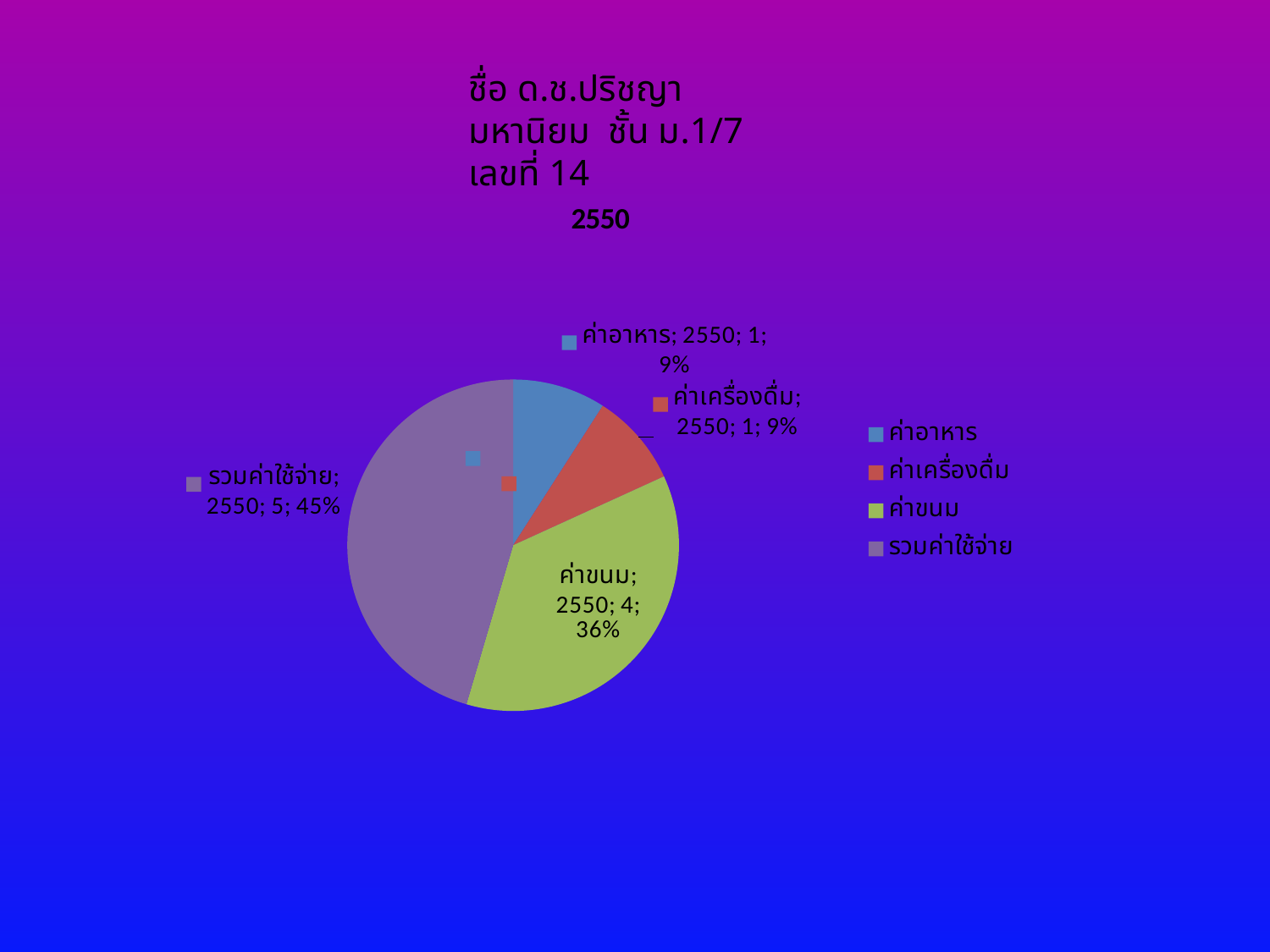
What kind of chart is shown on the slide? pie chart What is the value for รวมค่าใช้จ่าย? 5 What share of the pie does ค่าขนม represent? 36% Which slice is the largest? รวมค่าใช้จ่าย What is the difference between the values for รวมค่าใช้จ่าย and ค่าขนม? 1 What is the value for ค่าอาหาร? 1 What is the title of the chart? 2550 How many entries does the legend list? 4 How many slices does the pie chart have? 4 What share of the pie does รวมค่าใช้จ่าย represent? 45% What is the value for ค่าขนม? 4 What share of the pie does ค่าเครื่องดื่ม represent? 9%